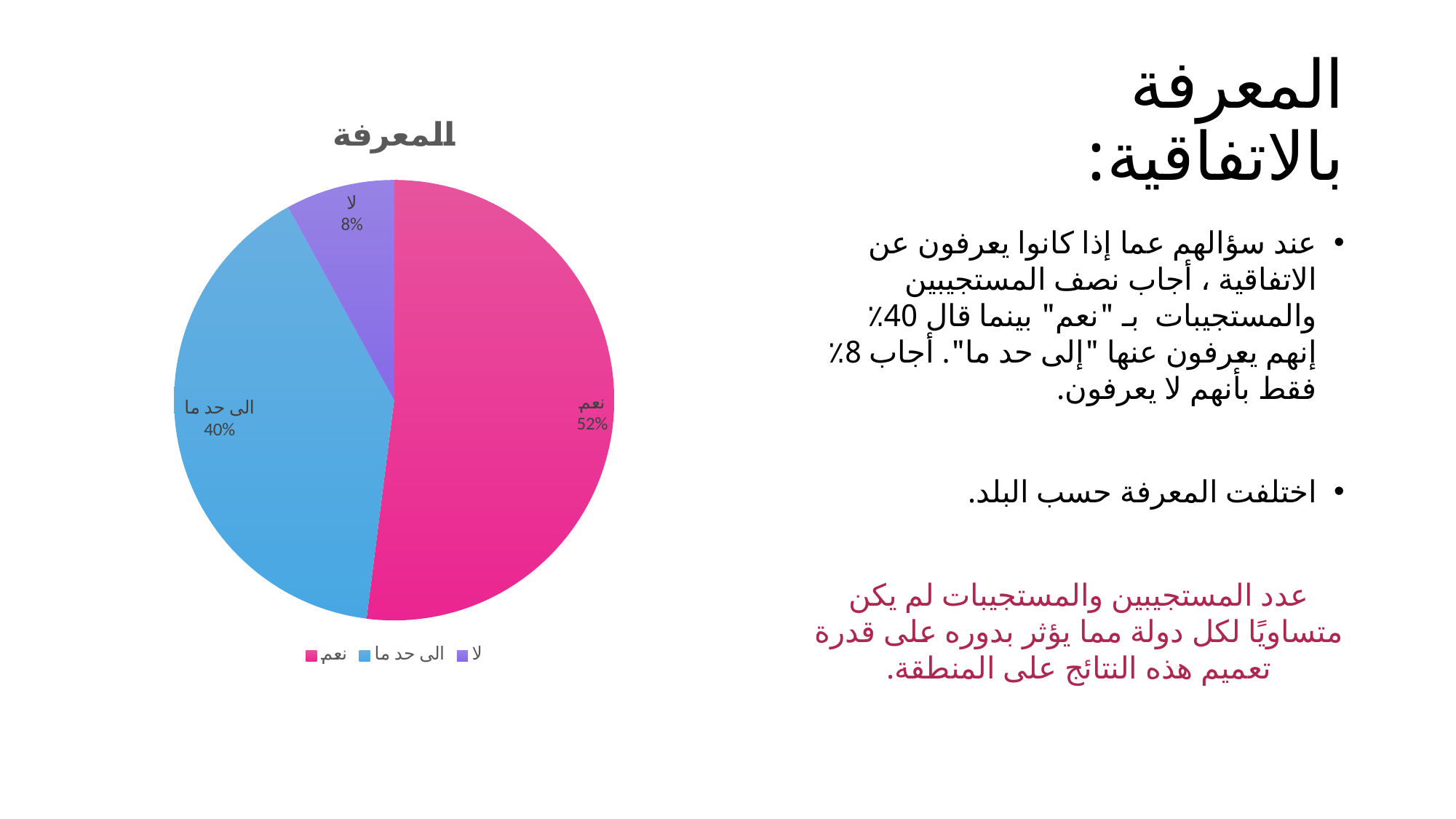
Which category has the largest slice of the pie? نعم What is the title of the chart? المعرفة What is the difference in percentage points between the "الى حد ما" slice and the "لا" slice? 32 How many entries does the chart legend list? 3 Which category has the smallest slice of the pie? لا What is the difference in percentage points between the "نعم" slice and the "الى حد ما" slice? 12 Which is larger, the "الى حد ما" slice or the "لا" slice? الى حد ما How many slices does the pie chart have? 3 What share of the pie does the "نعم" slice represent? 52% What share of the pie does the "لا" slice represent? 8% What share of the pie does the "الى حد ما" slice represent? 40% What type of chart is shown on the slide? Pie chart